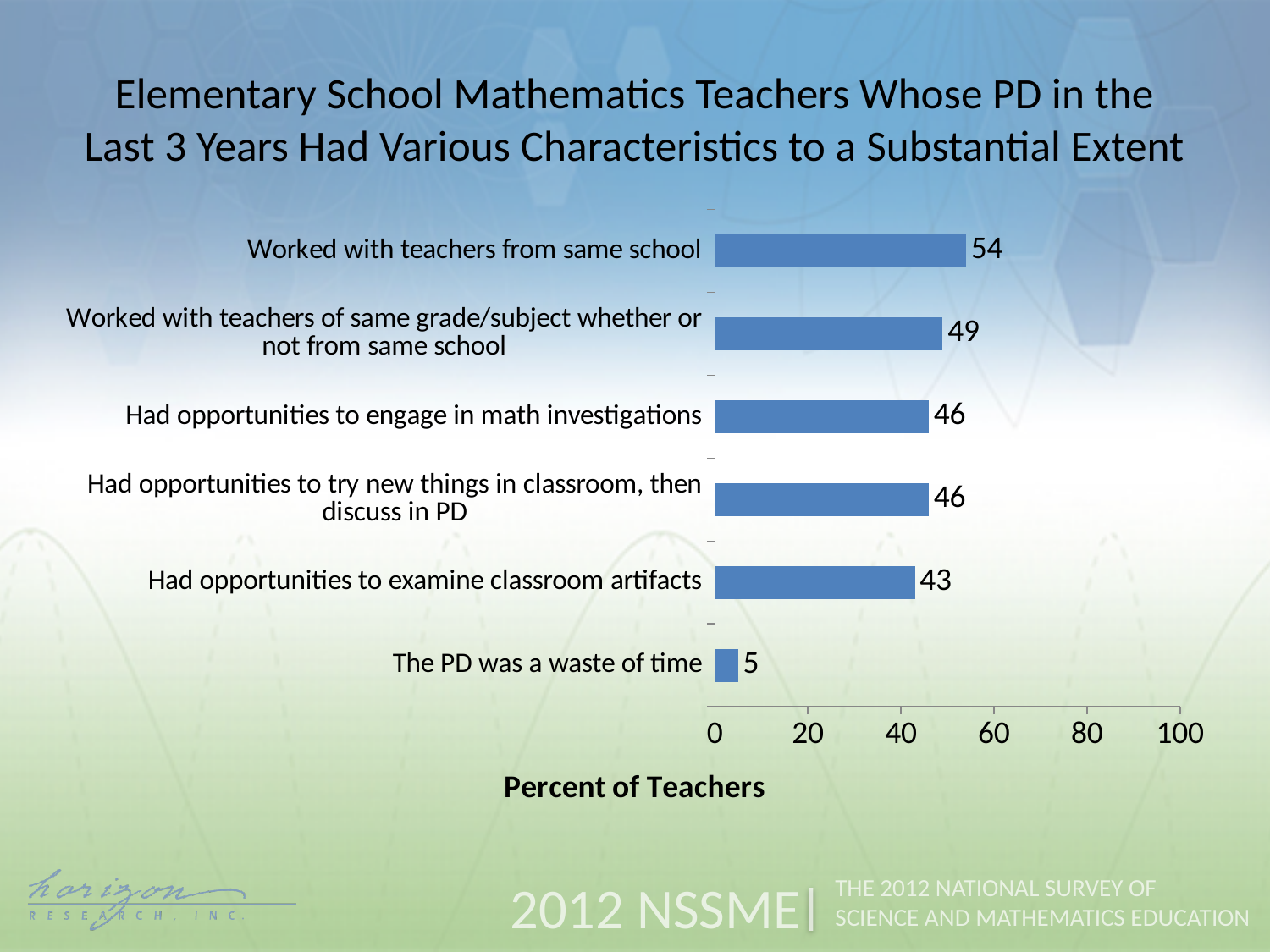
What kind of chart is shown on the slide? Bar chart Which characteristic has the lowest percent of teachers? The PD was a waste of time How many characteristics are shown in the chart? 6 Which is larger: the value for 'Worked with teachers of same grade/subject whether or not from same school' or 'Had opportunities to examine classroom artifacts'? Worked with teachers of same grade/subject whether or not from same school Is the value for 'Worked with teachers from same school' greater or less than 60? less What is the difference between 'Had opportunities to engage in math investigations' and 'The PD was a waste of time'? 41 What is the value for 'Had opportunities to examine classroom artifacts'? 43 What percent of teachers reported that their PD involved working with teachers from the same school? 54 Which characteristic has the highest percent of teachers? Worked with teachers from same school What is the difference between 'Worked with teachers from same school' and 'Worked with teachers of same grade/subject whether or not from same school'? 5 What is the label of the horizontal axis? Percent of Teachers What percent of teachers said the PD was a waste of time? 5